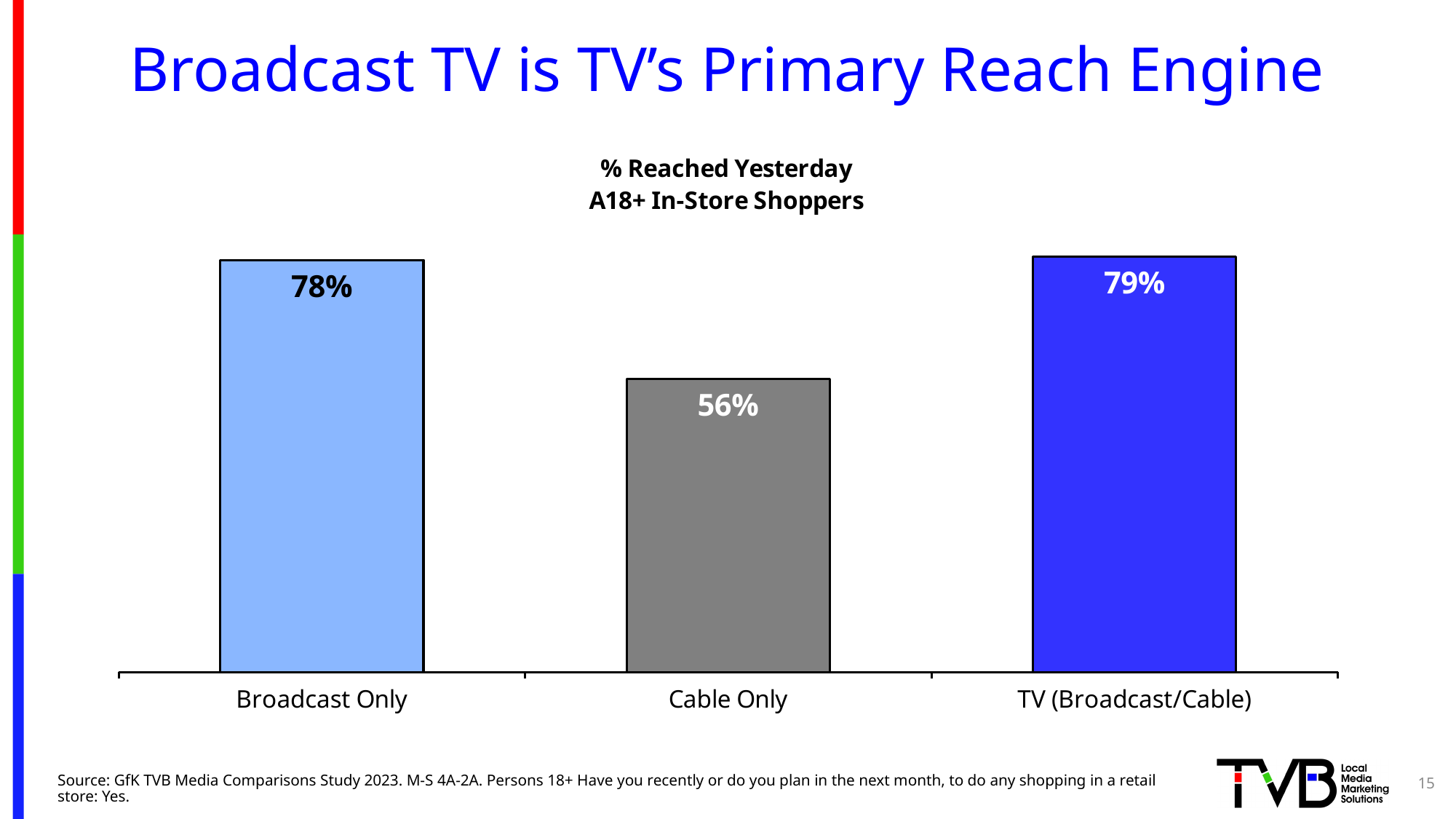
What kind of chart is shown on the slide? Bar chart What is the difference between the values for TV (Broadcast/Cable) and Cable Only? 23% What is the value for Cable Only? 56% Which is larger, the value for Broadcast Only or the value for Cable Only? Broadcast Only What colour is the bar for Cable Only? Gray What is the value for TV (Broadcast/Cable)? 79% Which category has the lowest value? Cable Only What is the value for Broadcast Only? 78% How many categories are shown in the chart? 3 What is the difference between the values for Broadcast Only and Cable Only? 22% What is the title of the chart? % Reached Yesterday A18+ In-Store Shoppers